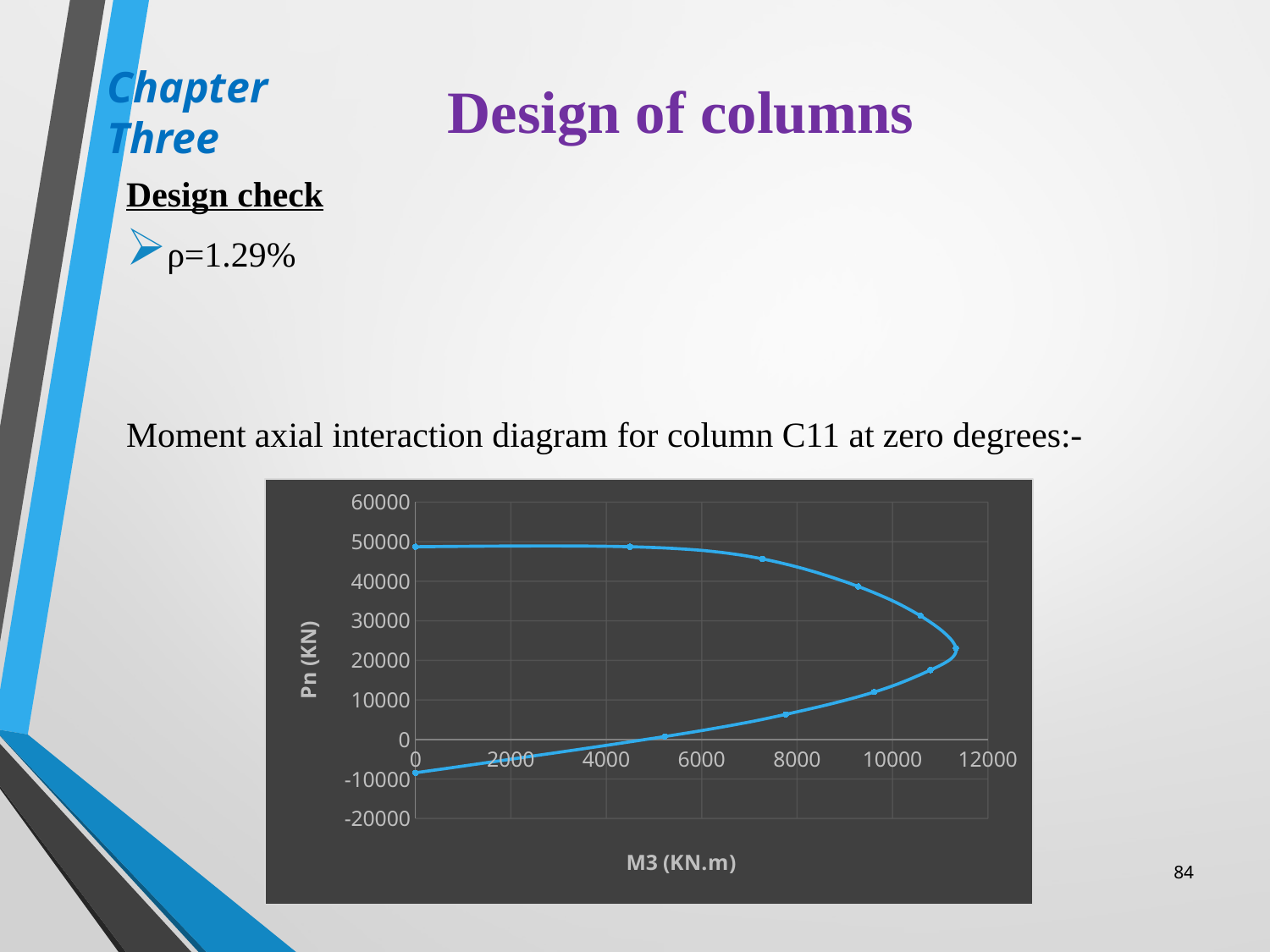
What kind of chart is shown on the slide? Line chart (scatter with smooth line) What is the lowest tick value shown on the vertical axis? -20000 What is the title of the vertical axis of the chart? Pn (KN) Is the highest Pn value plotted on the curve greater or less than 50000? less What is the highest tick value shown on the horizontal axis? 12000 Is the highest Pn value plotted on the curve greater or less than 40000? greater Is the largest M3 value reached by the curve greater or less than 10000? greater Which is larger: the Pn value of the curve at M3 = 0 on the upper branch, or the Pn value at the point of maximum M3? The Pn value at M3 = 0 on the upper branch